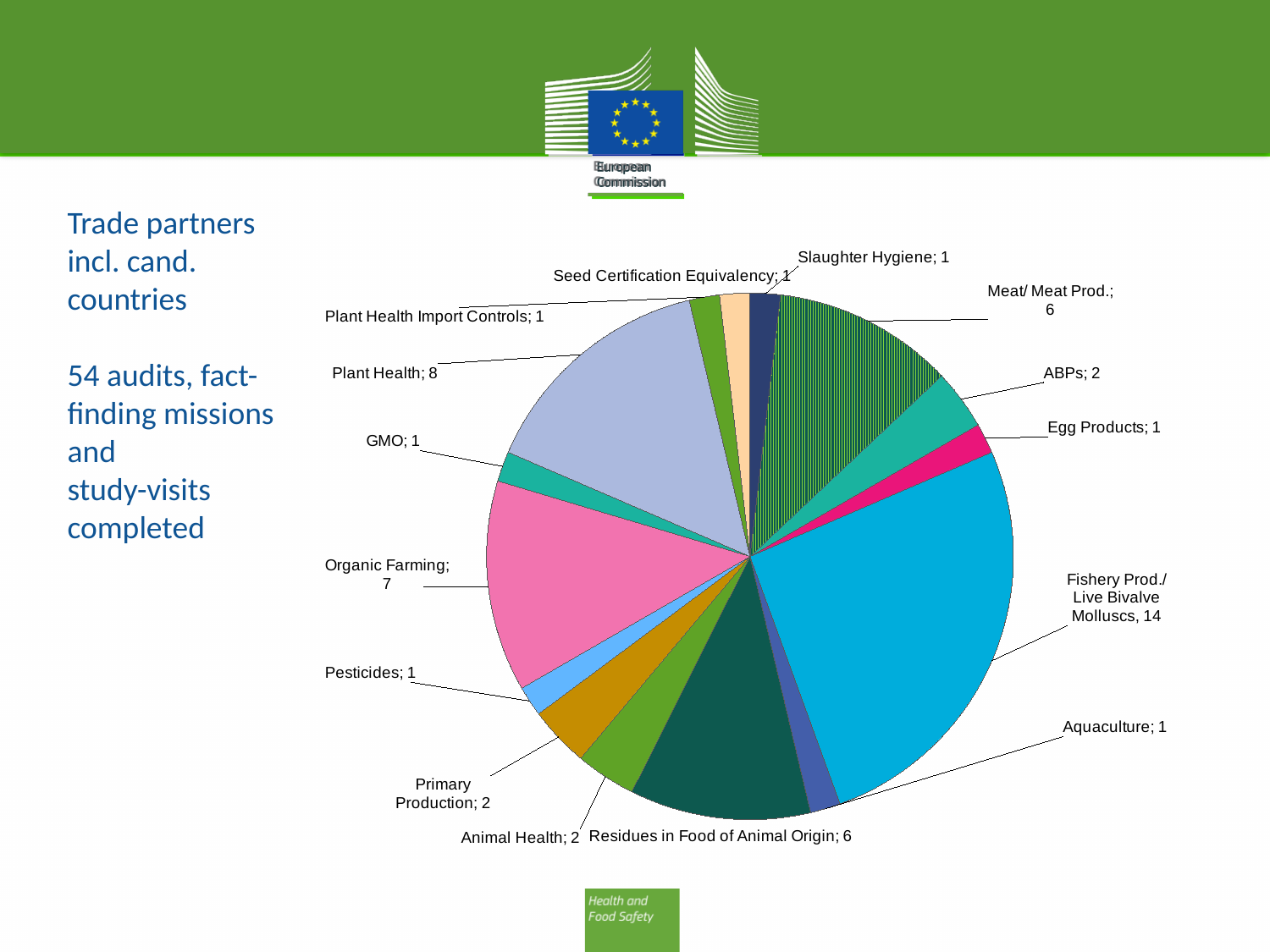
What kind of chart is shown on the slide? pie chart What is the difference between the values for Fishery Prod./ Live Bivalve Molluscs and Plant Health? 6 How many categories (slices) does the pie chart have? 15 What is the value for Organic Farming? 7 How many audits, fact-finding missions and study-visits does the slide say were completed? 54 What is the value for Fishery Prod./ Live Bivalve Molluscs? 14 What is the value for Residues in Food of Animal Origin? 6 What is the combined value of Primary Production and Animal Health? 4 What is the value for ABPs? 2 What is the value for Plant Health? 8 Which category has the largest slice of the pie? Fishery Prod./ Live Bivalve Molluscs Which is larger, the value for Organic Farming or the value for Meat/ Meat Prod.? Organic Farming